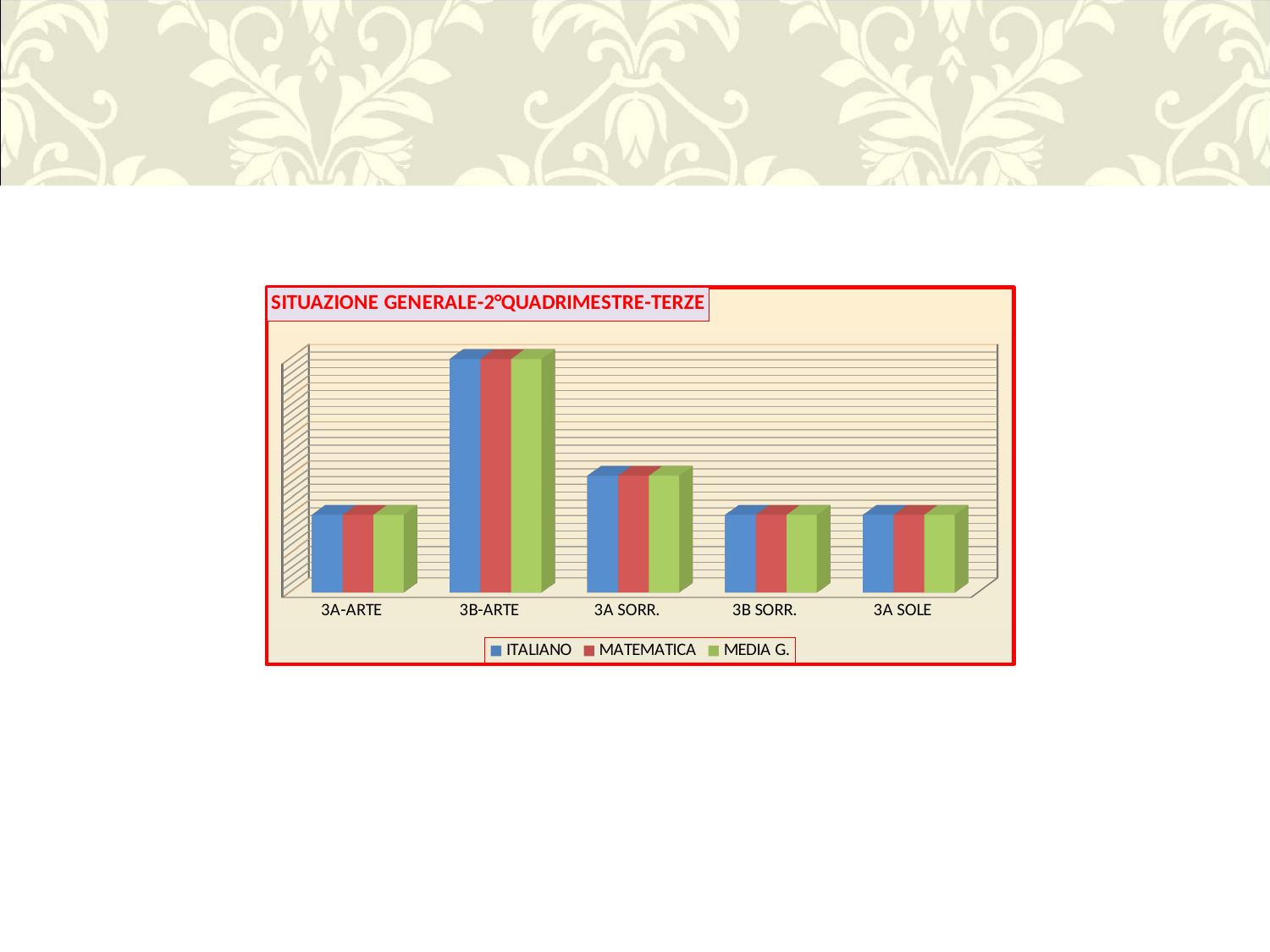
Which is larger, the MATEMATICA value for 3A SORR. or the MATEMATICA value for 3B SORR.? 3A SORR. How many categories are shown on the x axis of the chart? 5 Which category has the second-highest bars in the chart? 3A SORR. How many series does the legend list? 3 What kind of chart is shown on the slide? bar chart Which is larger, the MEDIA G. value for 3A-ARTE or the MEDIA G. value for 3B-ARTE? 3B-ARTE What is the title of the chart? SITUAZIONE GENERALE-2°QUADRIMESTRE-TERZE Which is larger, the ITALIANO value for 3B-ARTE or the ITALIANO value for 3A SORR.? 3B-ARTE Which series are listed in the legend? ITALIANO, MATEMATICA, MEDIA G. Which category has the highest bars in the chart? 3B-ARTE